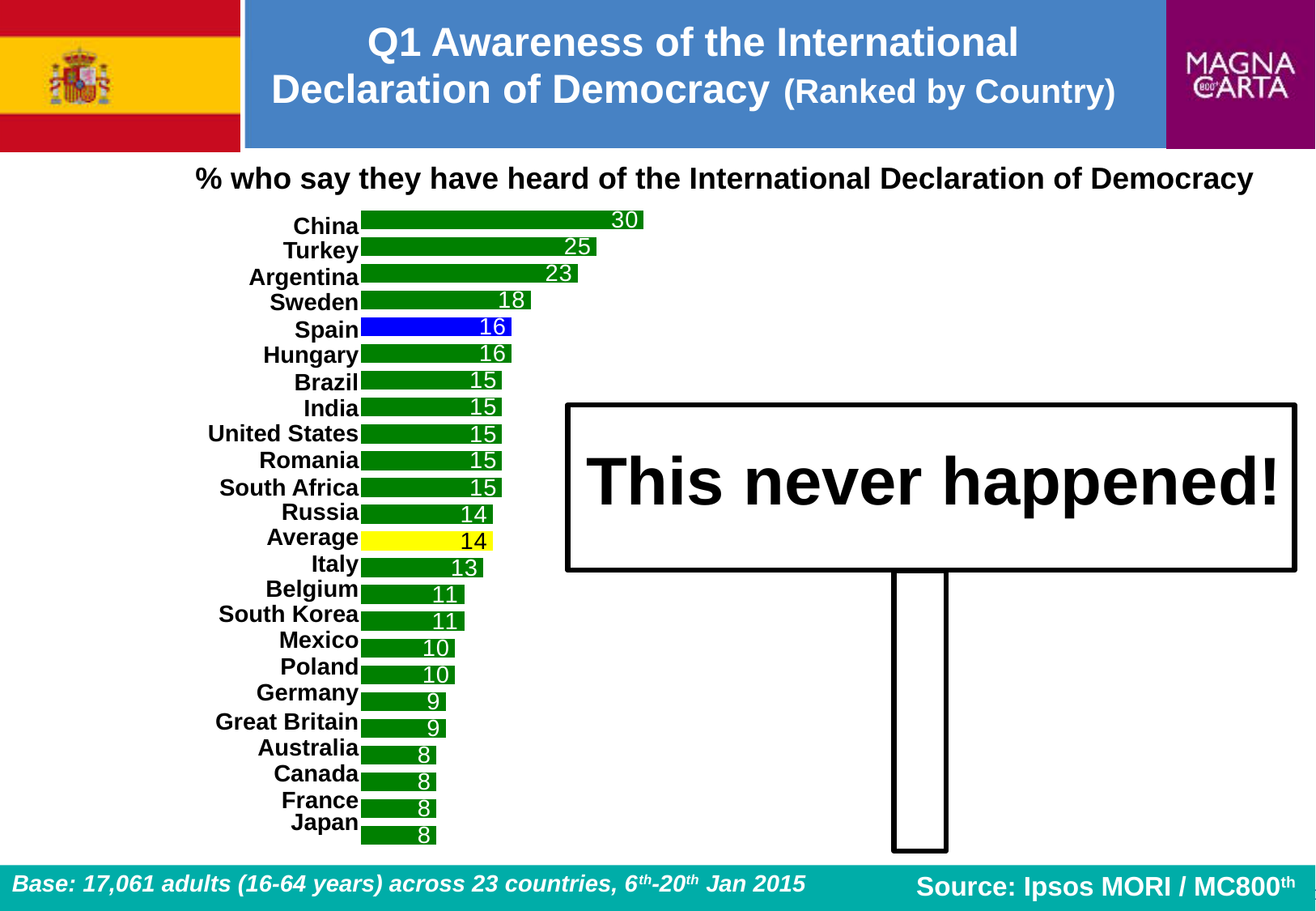
What kind of chart is shown on the slide? Bar chart What is the lowest value shown on the chart? 8 What is the value shown for Italy? 13 How many bars are shown on the chart, including the Average bar? 24 Which country has the highest percentage who say they have heard of the International Declaration of Democracy? China What percentage of people in China say they have heard of the International Declaration of Democracy? 30 What is the difference between the values for China and Turkey? 5 Which has a higher value, Sweden or Argentina? Argentina What is the value shown for the Average bar? 14 Which has a higher value, Germany or Mexico? Mexico What is the difference between the values for Spain and the Average? 2 What is the value shown for Spain? 16